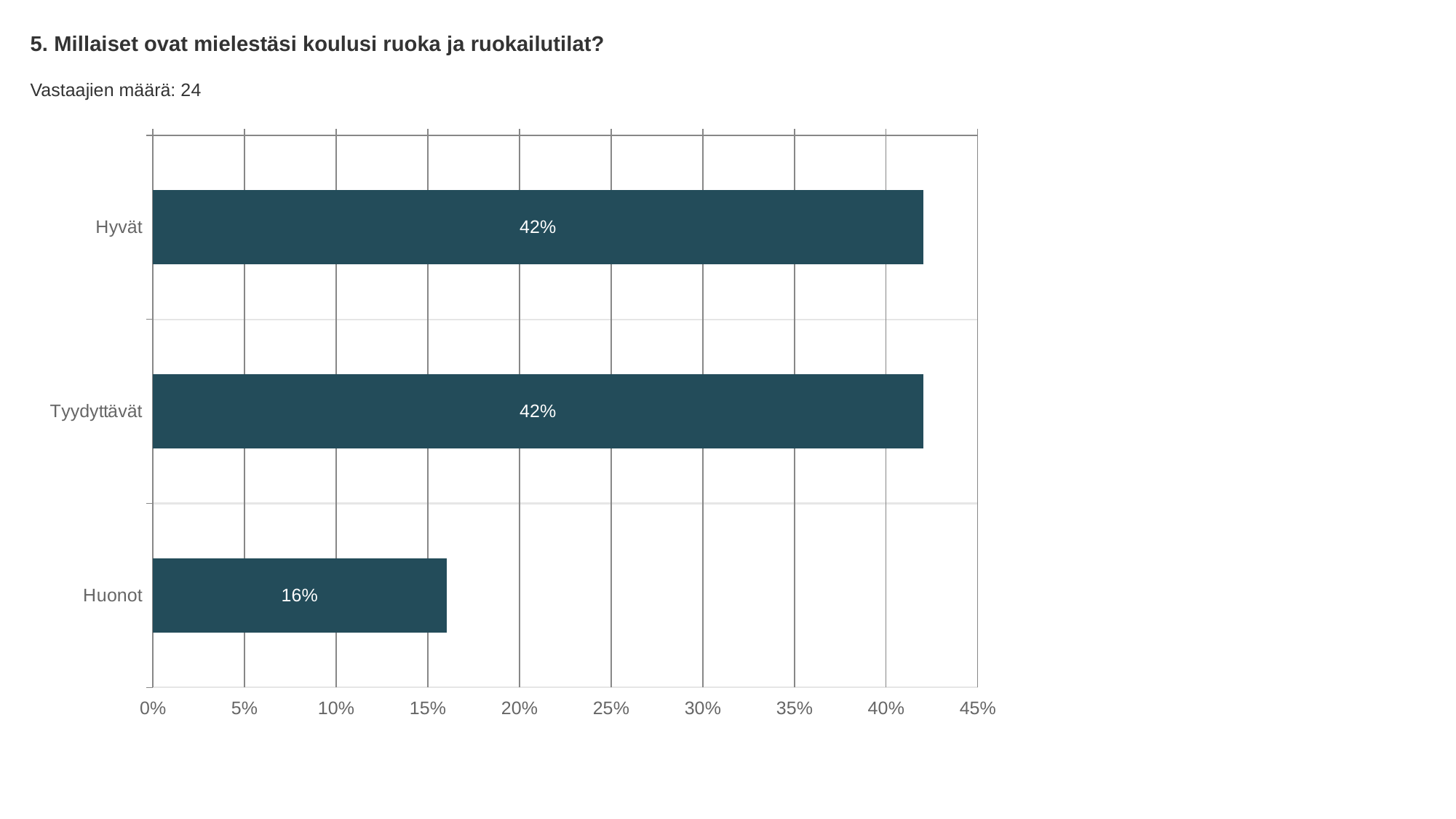
How many categories are shown in the chart? 3 What is the title of the chart? 5. Millaiset ovat mielestäsi koulusi ruoka ja ruokailutilat? What is the value for Hyvät? 42% What is the value for Tyydyttävät? 42% How many respondents (Vastaajien määrä) does the slide report? 24 What is the difference between the values for Hyvät and Huonot? 26% Which category has the lowest value? Huonot Which is larger, the value for Tyydyttävät or the value for Huonot? Tyydyttävät What kind of chart is shown on the slide? bar chart Is the value for Hyvät greater or less than 40%? greater Is the value for Huonot greater or less than 20%? less What is the value for Huonot? 16%